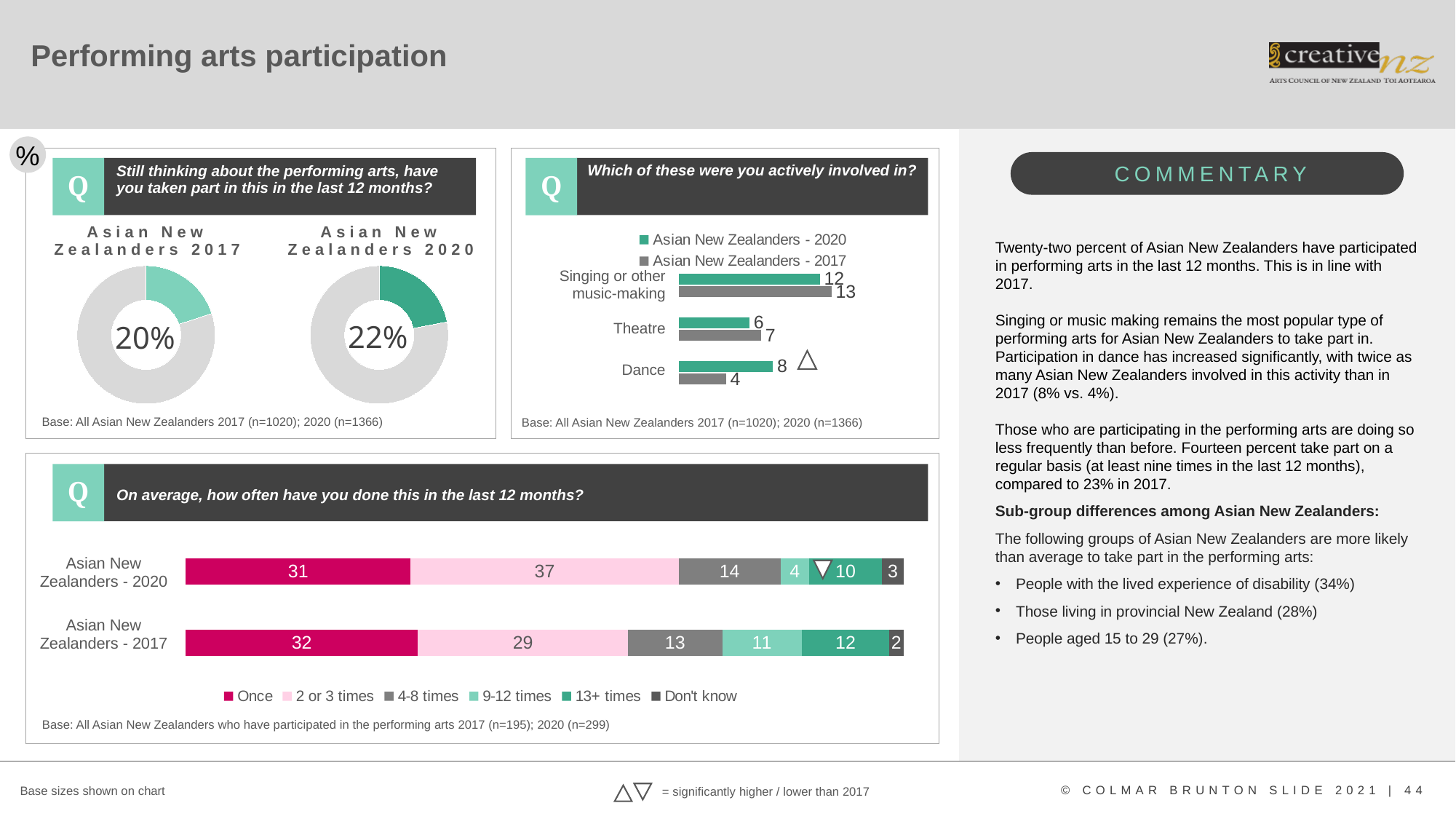
In the chart 'Which of these were you actively involved in?', what is the difference between the 2020 and 2017 values for Dance? 4 In the chart 'On average, how often have you done this in the last 12 months?', what is the value for '2 or 3 times' for Asian New Zealanders - 2020? 37 In the chart 'On average, how often have you done this in the last 12 months?', which is larger: the 'Once' value for 2020 or for 2017? 2017 In the chart 'On average, how often have you done this in the last 12 months?', what is the value for '9-12 times' for Asian New Zealanders - 2017? 11 In the chart 'Which of these were you actively involved in?', what kind of chart is used? Bar chart In the donut chart for Asian New Zealanders 2020 (top-left), what percentage took part in the performing arts in the last 12 months? 22% In the chart 'Which of these were you actively involved in?', what is the value for Dance for Asian New Zealanders - 2020? 8 In the chart 'On average, how often have you done this in the last 12 months?', how many categories does the legend list? 6 In the chart 'Which of these were you actively involved in?', what is the value for Singing or other music-making for Asian New Zealanders - 2017? 13 In the donut chart for Asian New Zealanders 2017 (top-left), what percentage took part in the performing arts in the last 12 months? 20% In the chart 'Which of these were you actively involved in?', how many series does the legend list? 2 In the chart 'Which of these were you actively involved in?', which activity has the highest value for Asian New Zealanders - 2020? Singing or other music-making